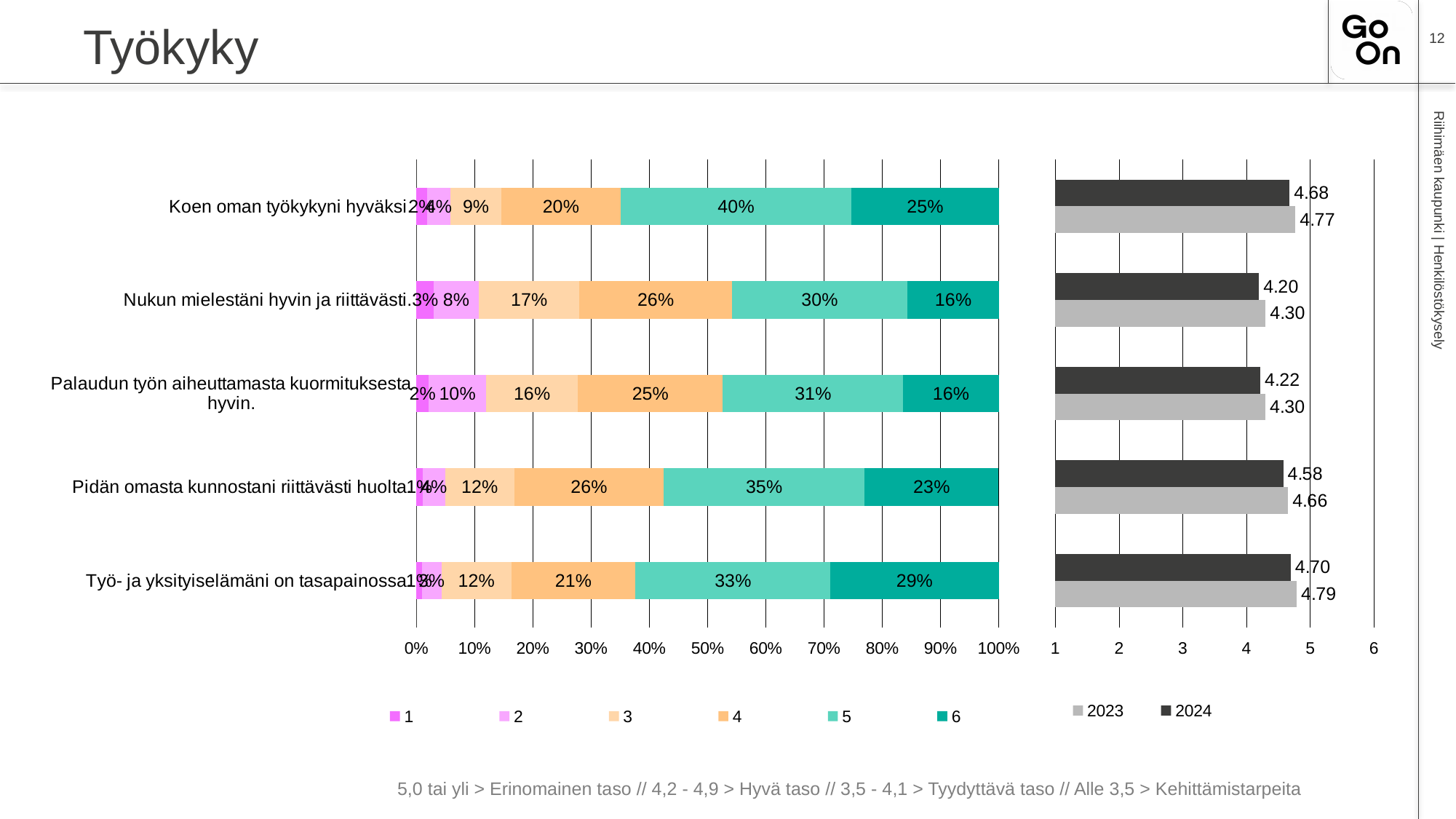
In the left stacked bar chart, how many rating categories does the legend list? 6 In the left stacked bar chart, what percentage gave a rating of 4 for "Nukun mielestäni hyvin ja riittävästi"? 26% In the right bar chart, what is the 2024 value for "Koen oman työkykyni hyväksi"? 4.68 In the left stacked bar chart, what is the difference between the rating-5 share for "Koen oman työkykyni hyväksi" and for "Nukun mielestäni hyvin ja riittävästi"? 10 percentage points In the left stacked bar chart, which statement has the highest share of rating 6? Työ- ja yksityiselämäni on tasapainossa In the left stacked bar chart, what percentage gave a rating of 6 for "Työ- ja yksityiselämäni on tasapainossa"? 29% In the right bar chart, what is the difference between the 2023 and 2024 values for "Pidän omasta kunnostani riittävästi huolta"? 0.08 How many statements (categories) are shown in the left stacked bar chart? 5 In the right bar chart, which statement has the lowest 2024 value? Nukun mielestäni hyvin ja riittävästi In the right bar chart, what is the 2023 value for "Palaudun työn aiheuttamasta kuormituksesta hyvin"? 4.30 In the right bar chart, is the 2023 value for "Työ- ja yksityiselämäni on tasapainossa" larger or smaller than the 2024 value? larger In the left stacked bar chart, what percentage of respondents gave a rating of 5 for "Koen oman työkykyni hyväksi"? 40%